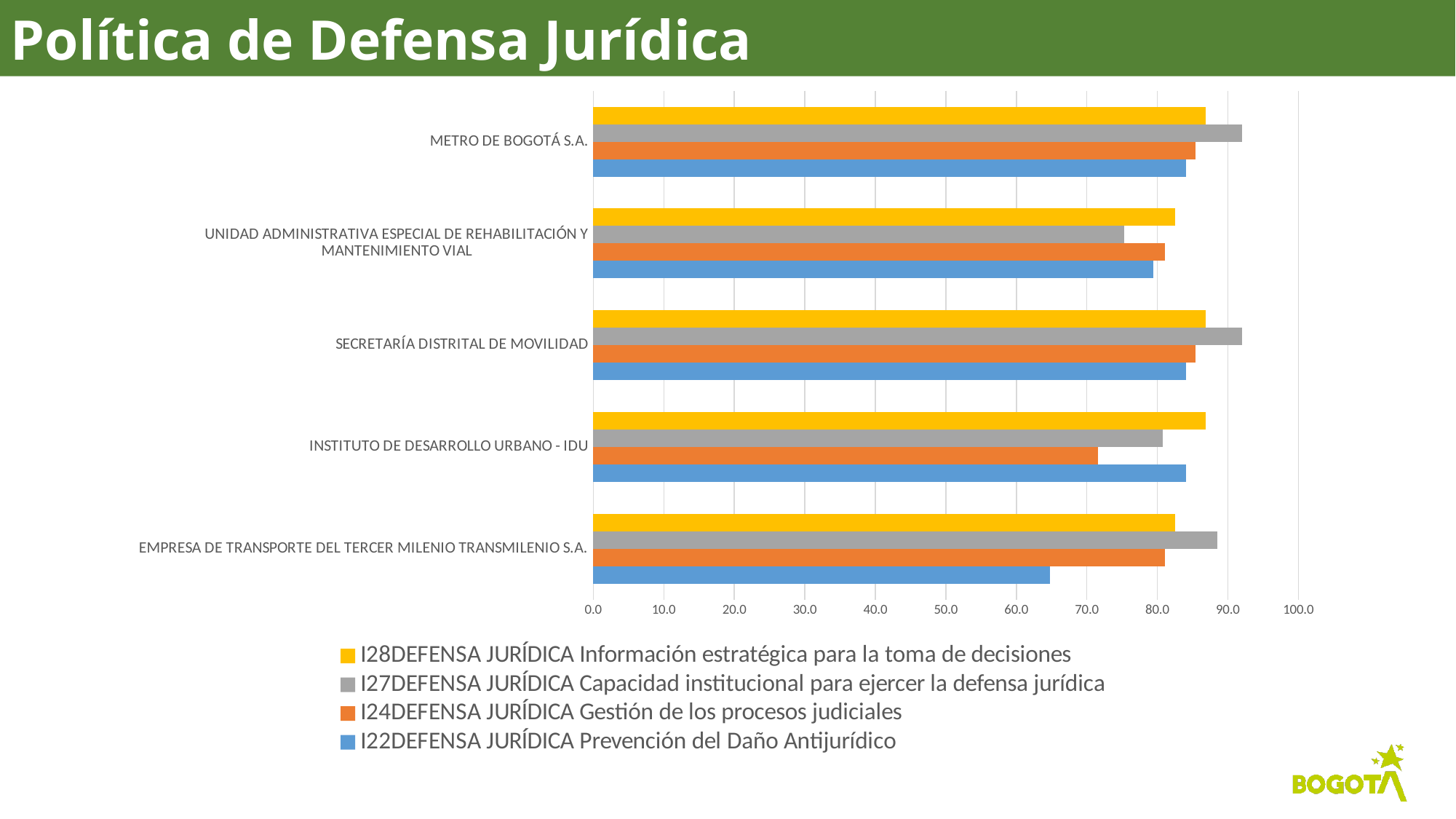
Is the value of I27DEFENSA JURÍDICA Capacidad institucional para ejercer la defensa jurídica for UNIDAD ADMINISTRATIVA ESPECIAL DE REHABILITACIÓN Y MANTENIMIENTO VIAL greater or less than 80.0? less How many entities (categories) are listed on the vertical axis of the chart? 5 Is the value of I27DEFENSA JURÍDICA Capacidad institucional para ejercer la defensa jurídica for METRO DE BOGOTÁ S.A. greater or less than 90.0? greater Is the value of I22DEFENSA JURÍDICA Prevención del Daño Antijurídico for EMPRESA DE TRANSPORTE DEL TERCER MILENIO TRANSMILENIO S.A. greater or less than 70.0? less How many series does the chart legend list? 4 For INSTITUTO DE DESARROLLO URBANO - IDU, which is larger: I28DEFENSA JURÍDICA Información estratégica para la toma de decisiones or I24DEFENSA JURÍDICA Gestión de los procesos judiciales? I28DEFENSA JURÍDICA Información estratégica para la toma de decisiones For EMPRESA DE TRANSPORTE DEL TERCER MILENIO TRANSMILENIO S.A., which is larger: I27DEFENSA JURÍDICA Capacidad institucional para ejercer la defensa jurídica or I22DEFENSA JURÍDICA Prevención del Daño Antijurídico? I27DEFENSA JURÍDICA Capacidad institucional para ejercer la defensa jurídica Which entity has the lowest value for I24DEFENSA JURÍDICA Gestión de los procesos judiciales? INSTITUTO DE DESARROLLO URBANO - IDU What kind of chart is shown on the slide? Bar chart What colour represents the series I28DEFENSA JURÍDICA Información estratégica para la toma de decisiones in the chart? Yellow Which entity has the lowest value for I22DEFENSA JURÍDICA Prevención del Daño Antijurídico? EMPRESA DE TRANSPORTE DEL TERCER MILENIO TRANSMILENIO S.A.